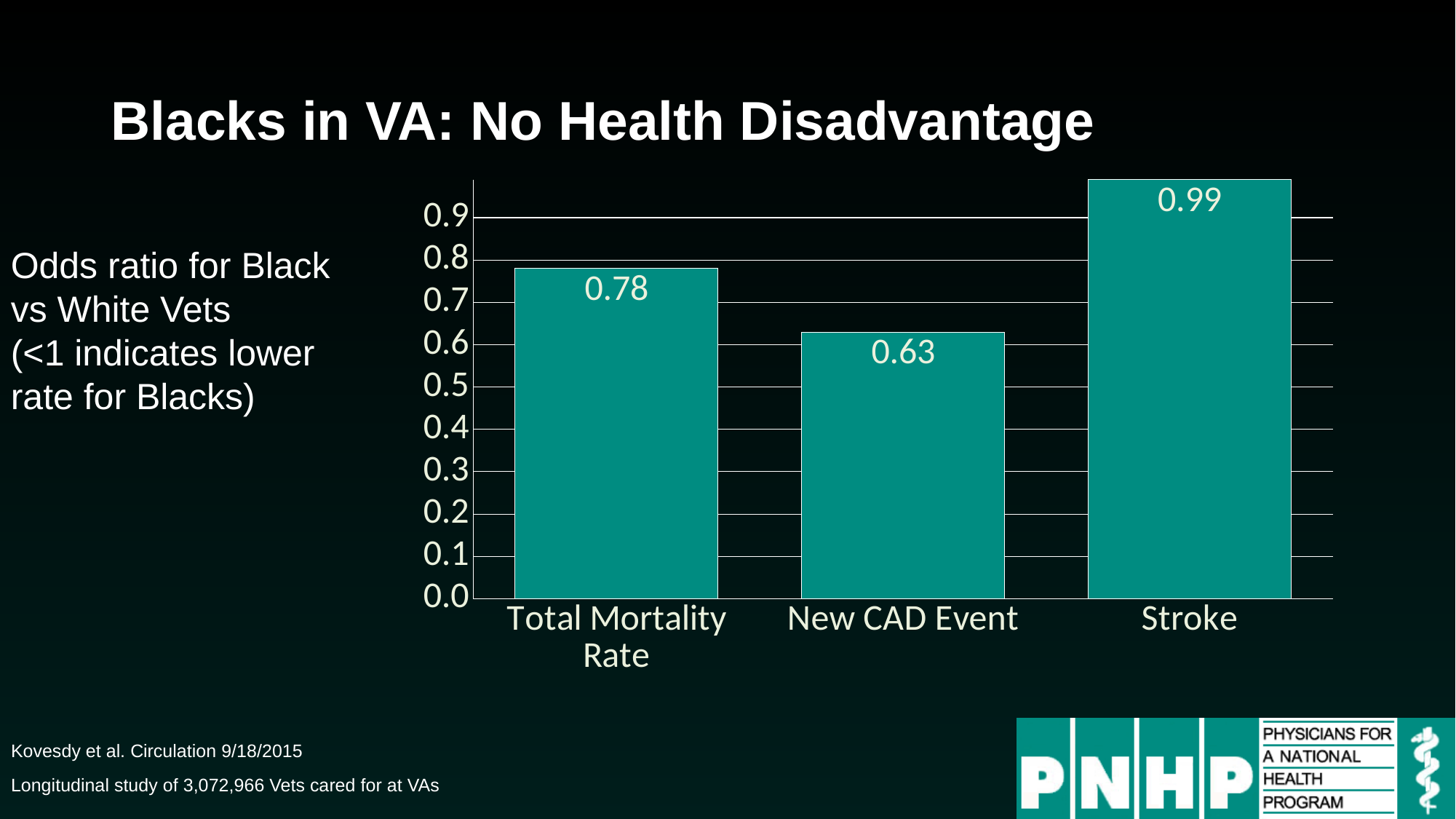
What kind of chart is shown on the slide? Bar chart How many categories are shown on the chart? 3 What is the odds ratio shown for New CAD Event? 0.63 Which is larger, the odds ratio for Total Mortality Rate or for New CAD Event? Total Mortality Rate What is the odds ratio shown for Stroke? 0.99 What is the difference between the odds ratios for Stroke and New CAD Event? 0.36 What is the difference between the odds ratios for Total Mortality Rate and New CAD Event? 0.15 Which category has the lowest odds ratio? New CAD Event Is the value for Stroke greater or less than 0.9? greater What is the odds ratio shown for Total Mortality Rate? 0.78 What is the title of the slide containing the chart? Blacks in VA: No Health Disadvantage Which category has the highest odds ratio? Stroke